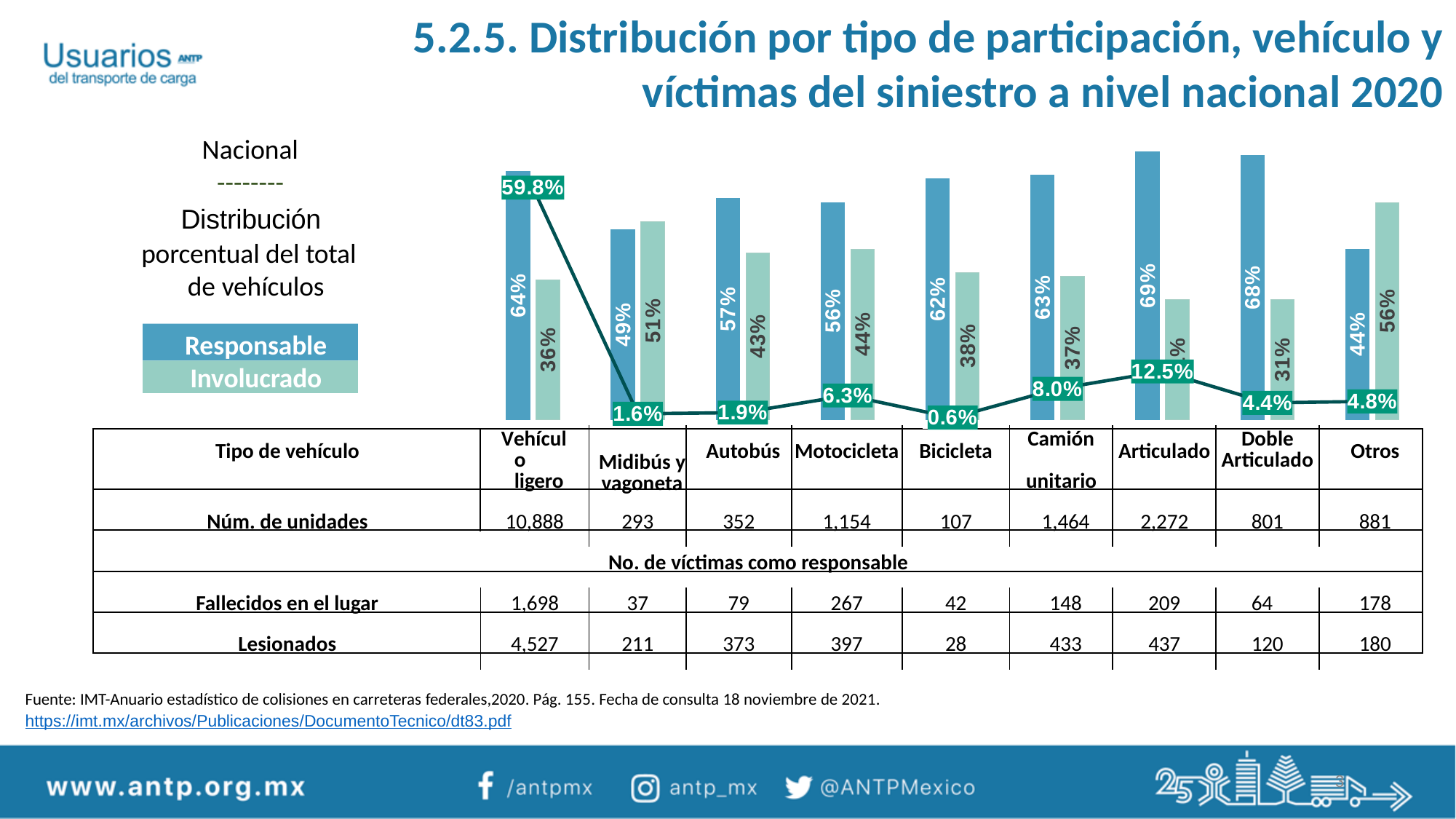
Which vehicle type has the highest Responsable percentage? Articulado For Otros, which is larger: the Responsable or the Involucrado percentage? Involucrado What kind of chart is used to show the Responsable and Involucrado percentages? Bar chart What is the difference between the Responsable and Involucrado percentages for Autobús? 14% What is the Responsable percentage for Vehículo ligero? 64% What is the Nacional distribution percentage shown on the line for Bicicleta? 0.6% What is the Nacional distribution percentage shown on the line for Vehículo ligero? 59.8% Which colour represents the Responsable series in the legend? Blue What is the Involucrado percentage for Midibús y vagoneta? 51% How many vehicle types are shown in the chart? 9 How many series does the legend list for the bars? 2 Which vehicle type has the lowest Nacional distribution percentage on the line? Bicicleta